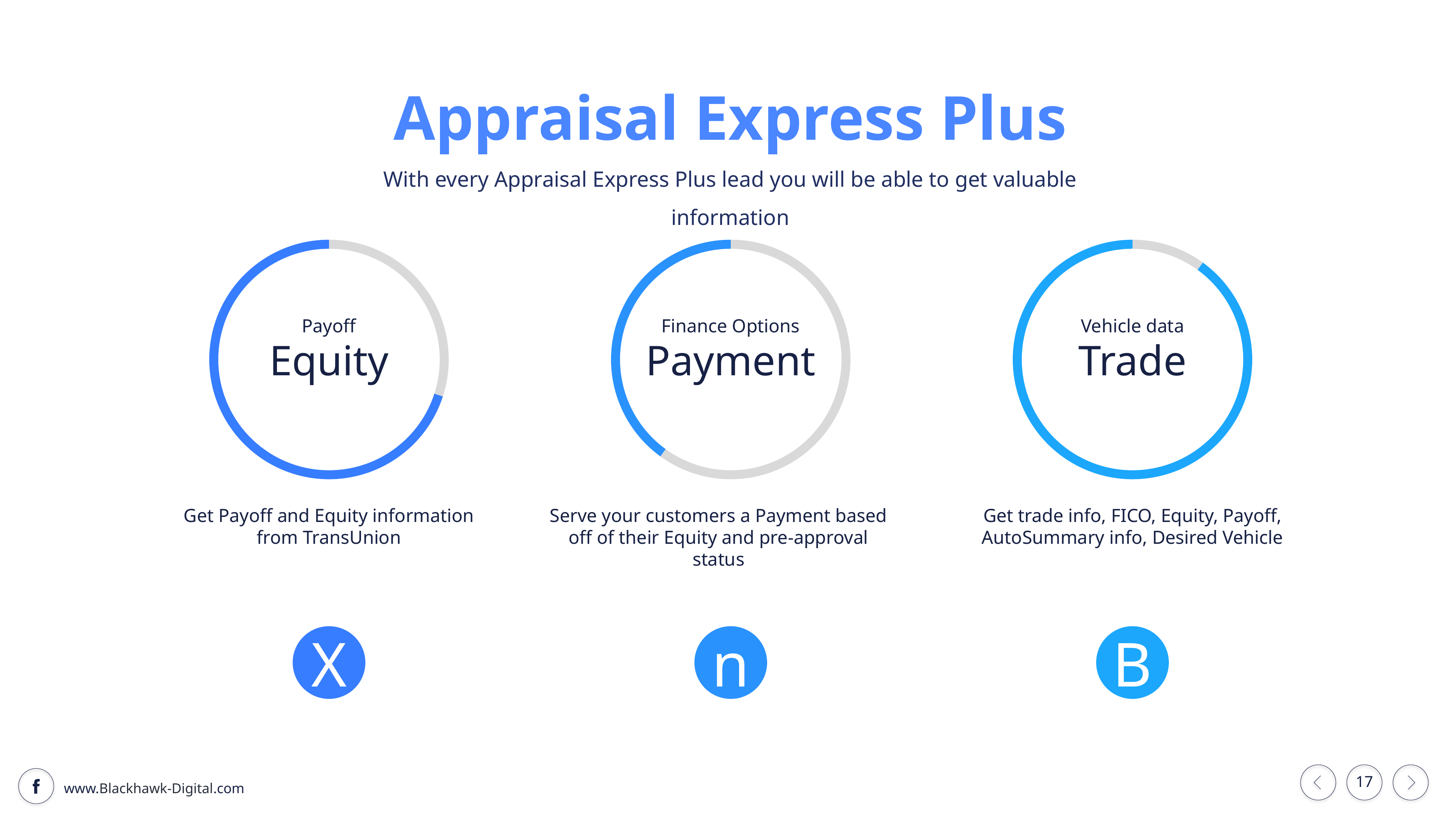
What label appears in the centre of the middle donut chart? Finance Options Payment Which donut chart has a larger filled portion, Vehicle data Trade or Payoff Equity? Vehicle data Trade Which donut chart has a larger filled portion, Payoff Equity or Finance Options Payment? Payoff Equity How many donut charts are shown on the slide? 3 Which donut chart has a larger filled portion, Vehicle data Trade or Finance Options Payment? Vehicle data Trade What label appears in the centre of the left donut chart? Payoff Equity What kind of chart is used for the Payoff Equity, Finance Options Payment and Vehicle data Trade figures? Donut chart Which of the three donut charts has the smallest filled (coloured) portion? Finance Options Payment Which of the three donut charts has the largest filled (coloured) portion? Vehicle data Trade